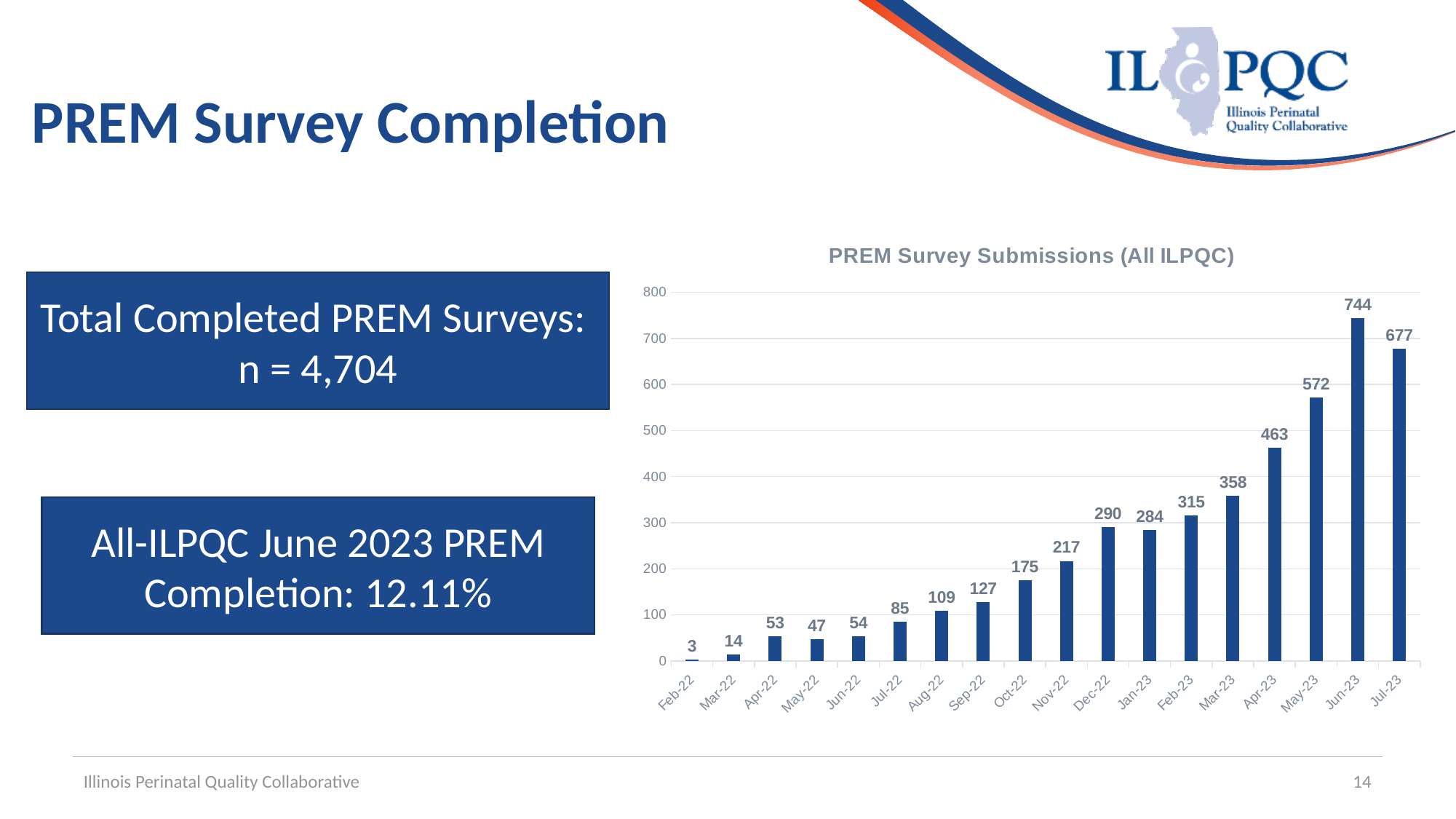
Which month has the highest number of PREM survey submissions? Jun-23 Which month has the lowest number of PREM survey submissions? Feb-22 How many months are shown on the x axis of the PREM Survey Submissions chart? 18 What is the value for Feb-22 in the PREM Survey Submissions chart? 3 What is the value for Dec-22 in the PREM Survey Submissions chart? 290 What is the title of the chart on the slide? PREM Survey Submissions (All ILPQC) What kind of chart is the PREM Survey Submissions chart? Bar chart Is the value for Apr-23 in the PREM Survey Submissions chart greater or less than 400? greater What is the difference between the Jun-23 and Jul-23 values in the PREM Survey Submissions chart? 67 Which is larger in the PREM Survey Submissions chart, Dec-22 or Jan-23? Dec-22 What is the value for Jun-23 in the PREM Survey Submissions chart? 744 Do the values in the PREM Survey Submissions chart generally rise or fall from Feb-22 to Jun-23? Rise